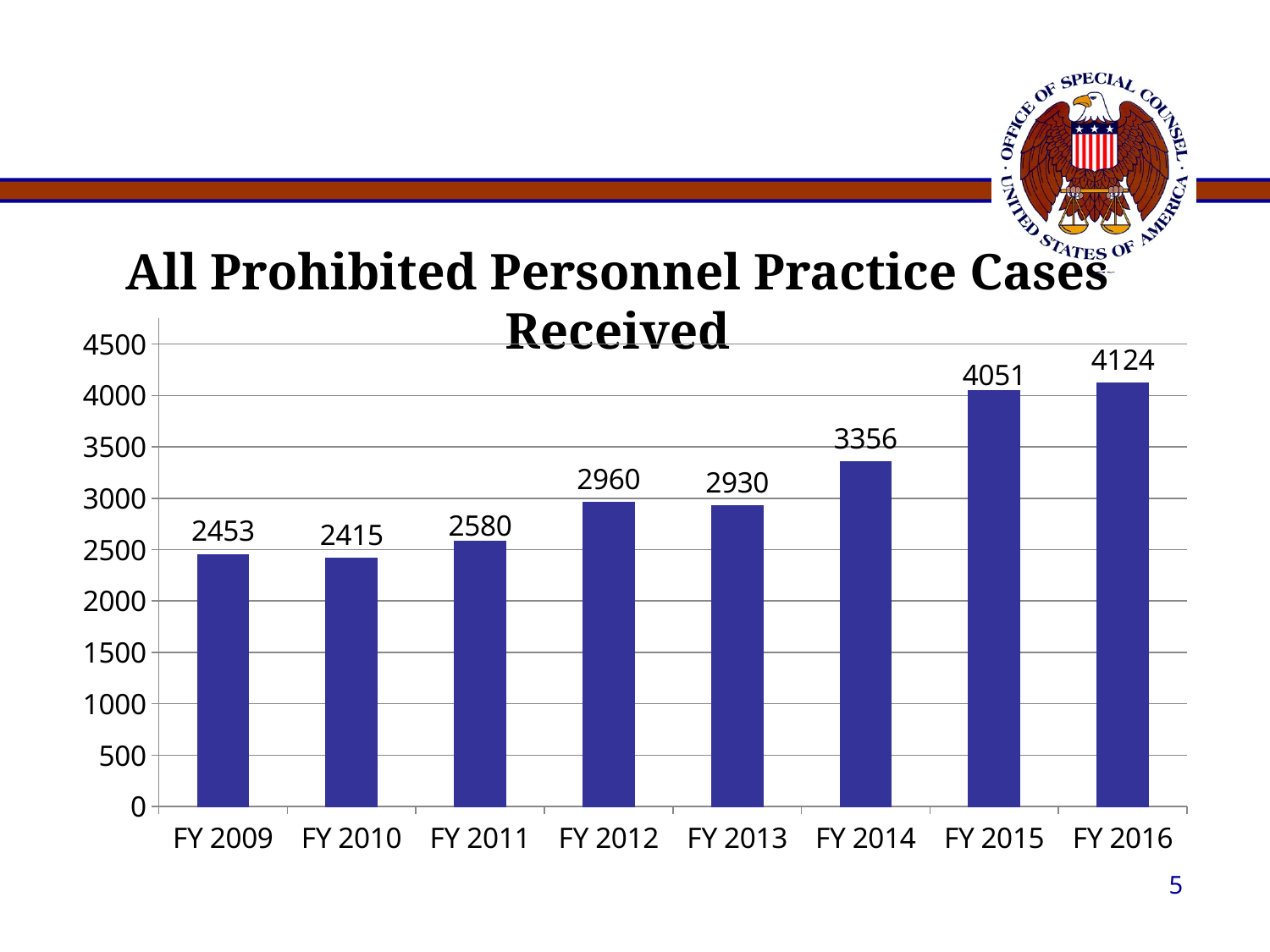
Which is larger, the value for FY 2012 or the value for FY 2013? FY 2012 What is the difference between the values for FY 2016 and FY 2015? 73 What kind of chart is shown on the slide? Bar chart What is the value for FY 2012? 2960 How many fiscal years are shown on the x axis? 8 Which fiscal year has the lowest number of cases received? FY 2010 What is the difference between the values for FY 2014 and FY 2013? 426 What is the value for FY 2009? 2453 What is the title of the chart? All Prohibited Personnel Practice Cases Received Is the value for FY 2014 greater or less than 3000? greater What is the value for FY 2015? 4051 Which fiscal year has the highest number of cases received? FY 2016